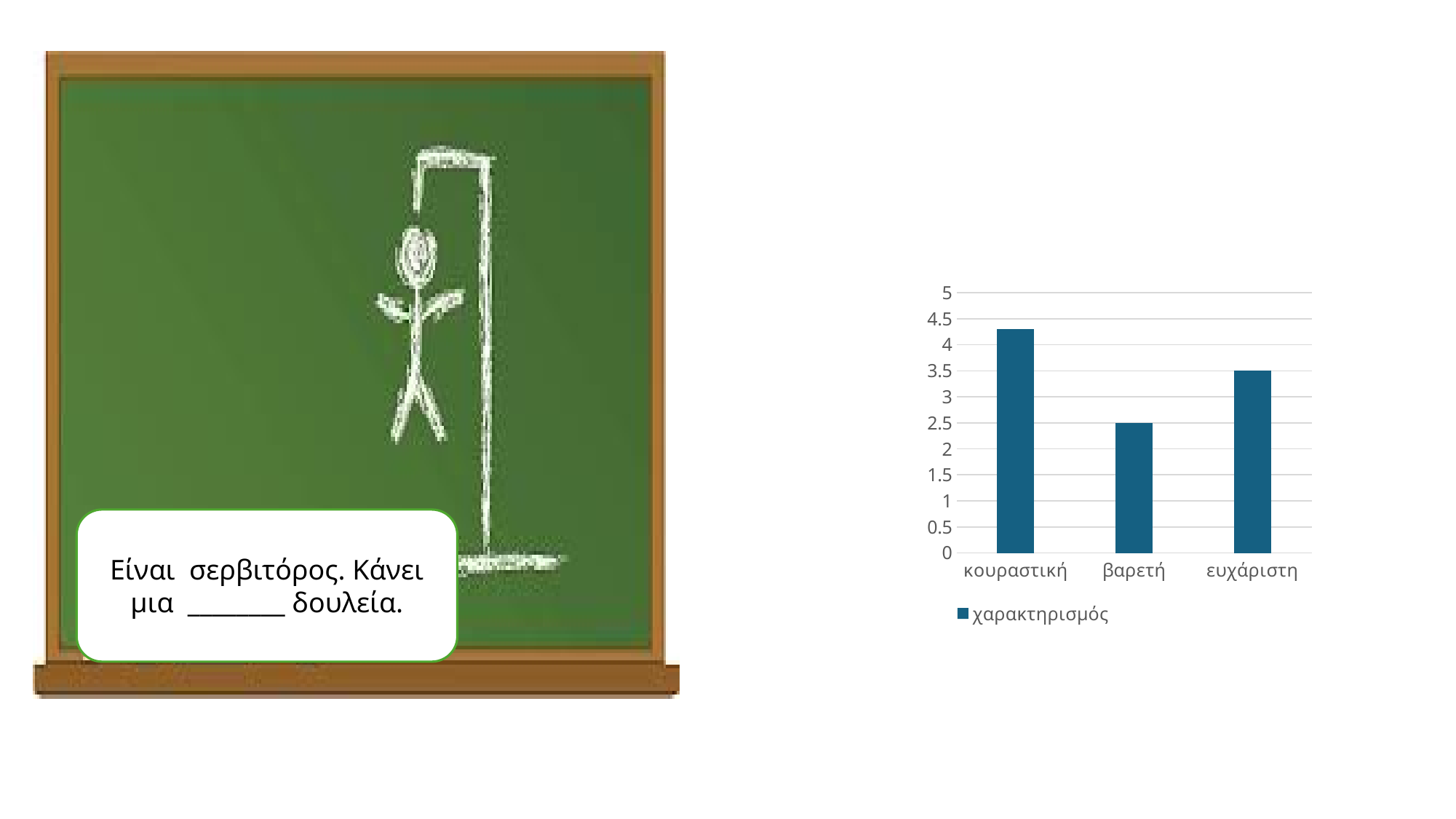
What is the highest value shown on the chart's vertical axis? 5 Which category has the highest bar in the chart? κουραστική What is the name of the series in the chart legend? χαρακτηρισμός What is the value for βαρετή in the chart? 2.5 Is the value for κουραστική greater or less than 4? greater How many categories are shown on the x axis of the chart? 3 What is the difference between the values for ευχάριστη and βαρετή? 1 How many series does the chart legend list? 1 What is the value for ευχάριστη in the chart? 3.5 Which is larger, the value for κουραστική or the value for ευχάριστη? κουραστική What kind of chart is shown on the slide? bar chart Which category has the lowest bar in the chart? βαρετή